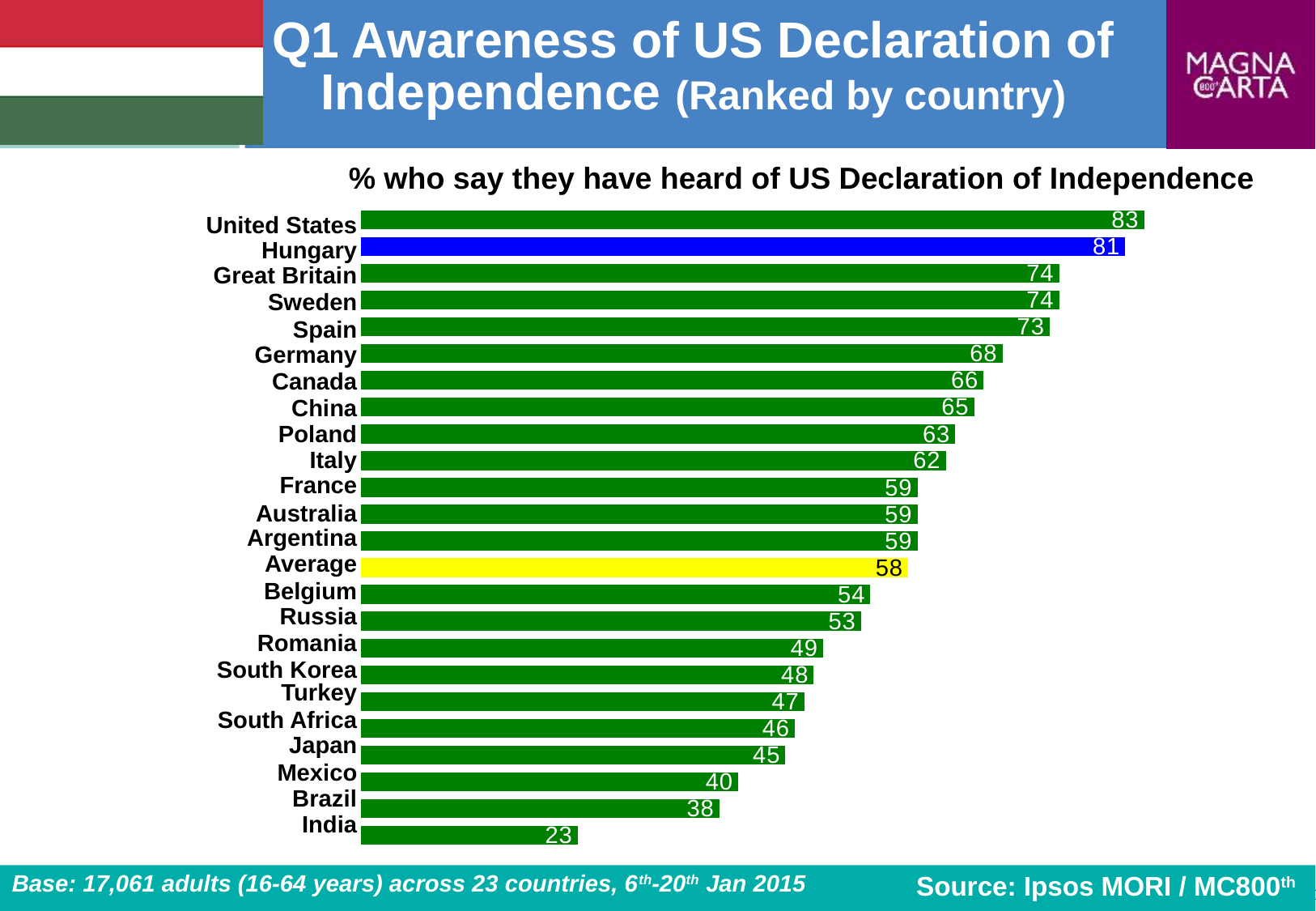
Which country has the highest value? United States Which bar is coloured blue? Hungary What is the value for Japan? 45 What is the value shown for Average? 58 Which country has the lowest value? India Which has a larger value, Canada or Belgium? Canada What kind of chart is shown on the slide? Bar chart What is the difference between the values for Spain and India? 50 What is the value for Germany? 68 How many bars are shown in the chart, including the Average bar? 24 What is the difference between the values for the United States and Hungary? 2 What is the value for Hungary? 81